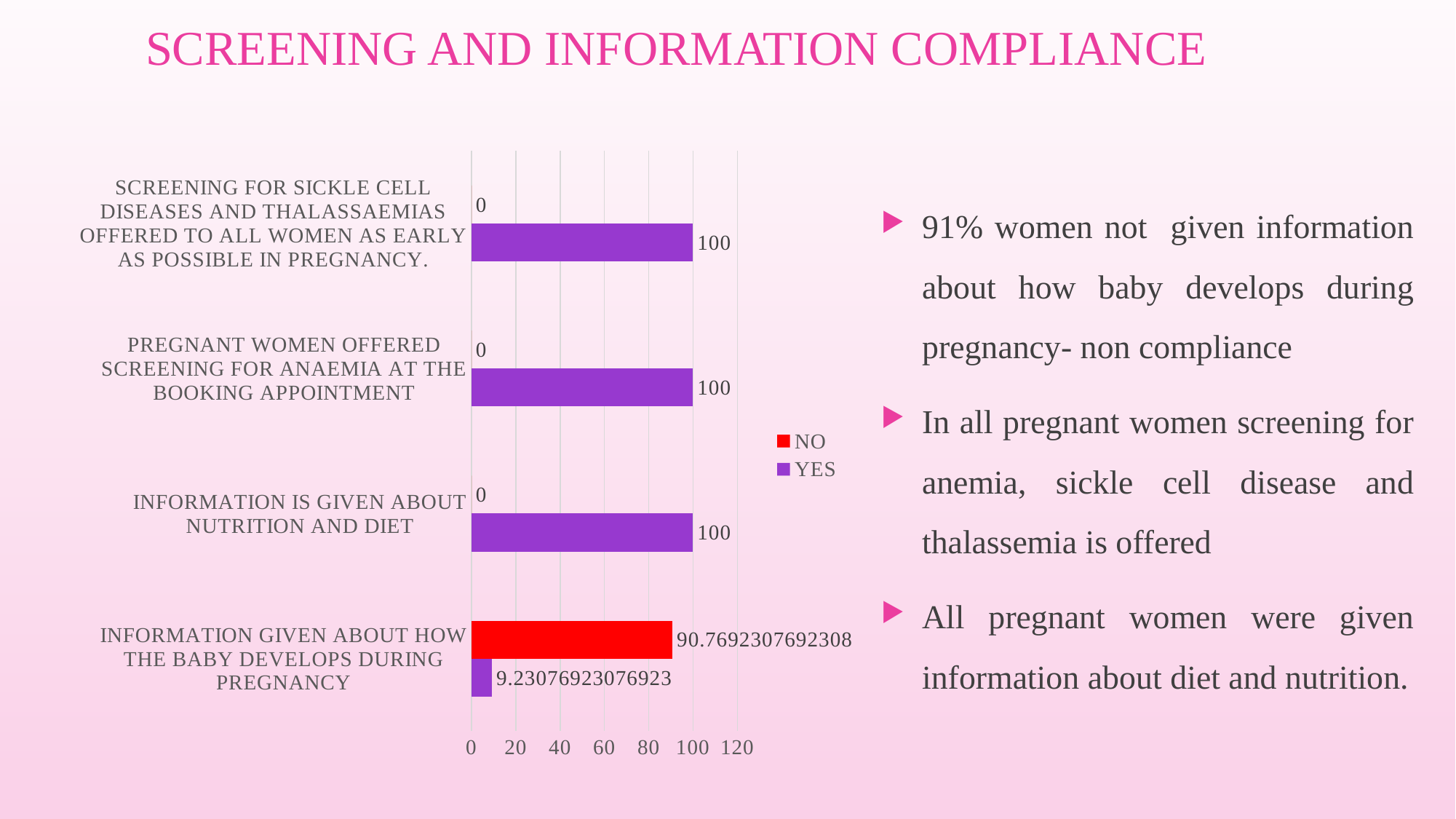
What type of chart is shown on the slide? bar chart For 'Information given about how the baby develops during pregnancy', which is larger, the NO value or the YES value? NO Which colour represents the NO series in the chart legend? red What is the NO value for 'Information given about how the baby develops during pregnancy'? 90.7692307692308 What is the YES value for 'Information given about how the baby develops during pregnancy'? 9.23076923076923 Which category has the highest NO value? Information given about how the baby develops during pregnancy Which category has the lowest YES value? Information given about how the baby develops during pregnancy What is the difference between the YES value for 'Information is given about nutrition and diet' and the YES value for 'Information given about how the baby develops during pregnancy'? 90.76923076923077 How many categories are shown on the chart? 4 How many series does the chart legend list? 2 What is the NO value for 'Pregnant women offered screening for anaemia at the booking appointment'? 0 What is the YES value for 'Information is given about nutrition and diet'? 100